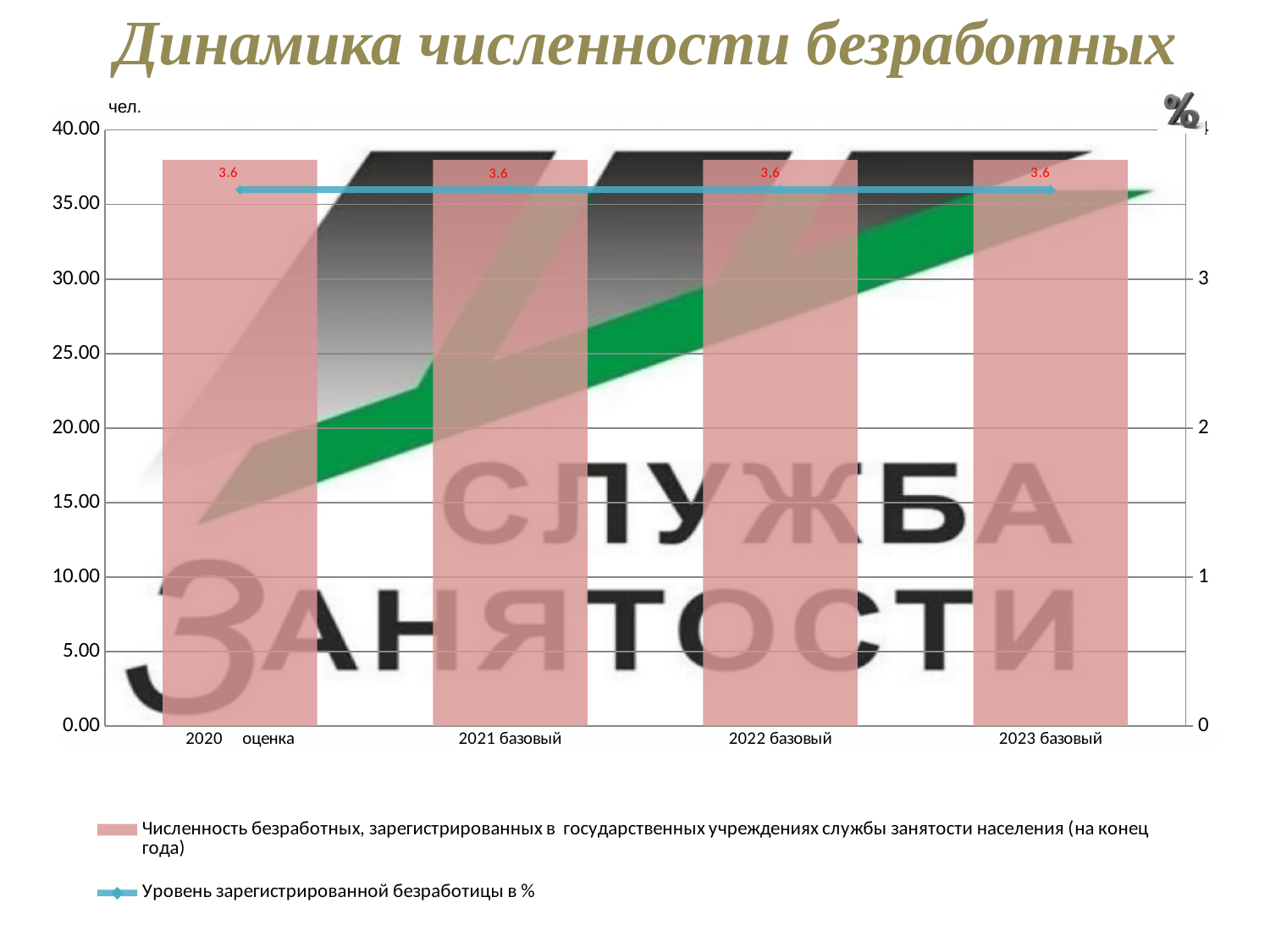
What kind of chart is this? A combined bar and line chart What value does the line series show for 2023 базовый? 3.6 What is the title of the chart? Динамика численности безработных Is the bar value for 2020 оценка greater or less than 35? greater What is the registered unemployment rate (Уровень зарегистрированной безработицы в %) shown for 2021 базовый? 3.6 Does the registered unemployment rate rise, fall or stay flat from 2020 to 2023? It stays flat What unit label is shown above the left vertical axis? чел. How many categories (years) are shown on the x axis? 4 What is the difference between the unemployment rate in 2023 базовый and in 2020 оценка? 0 Is the bar value for 2022 базовый greater or less than 40? less How many series does the legend list? 2 What value does the line series show for 2020 оценка? 3.6